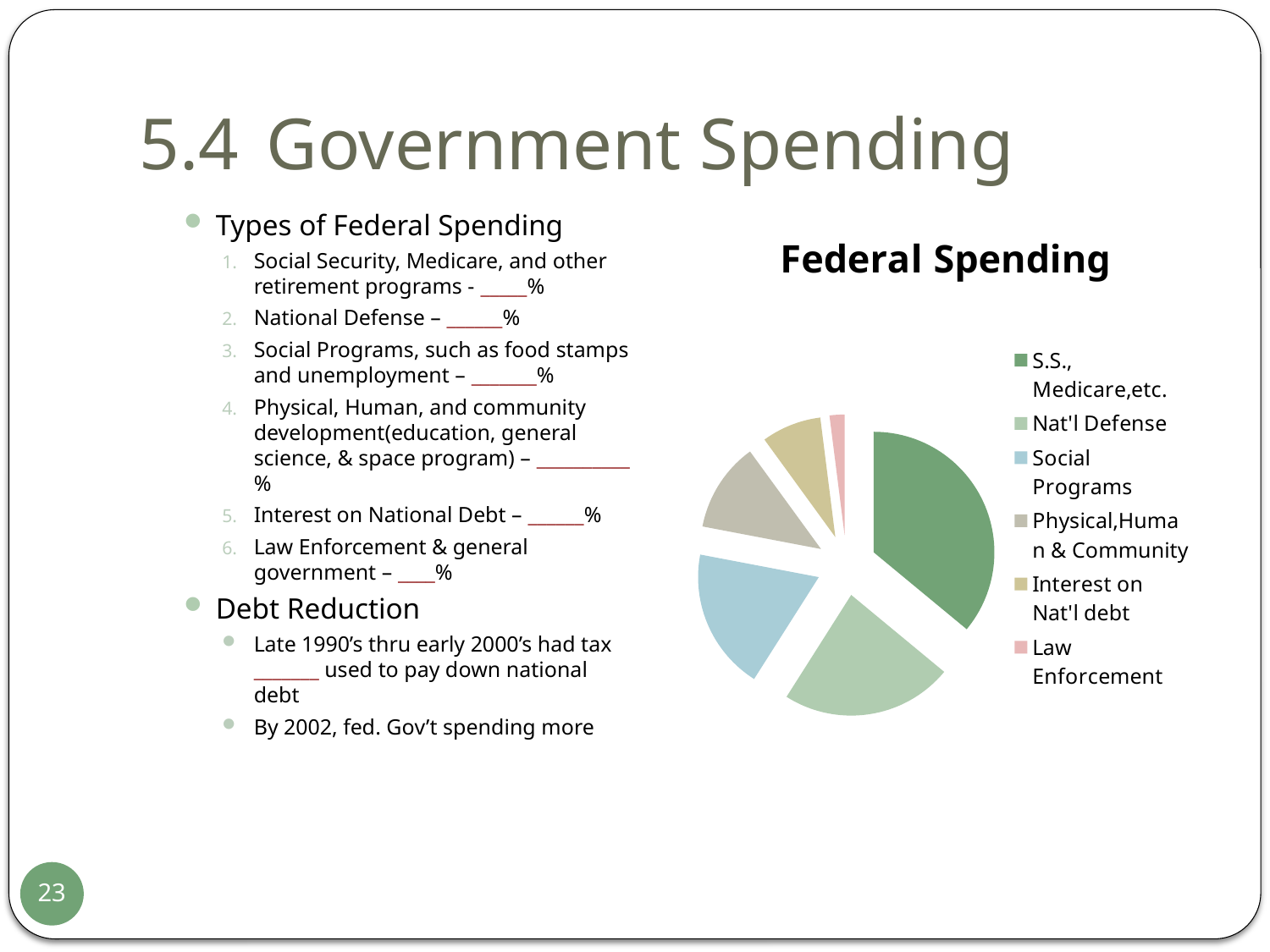
In the Federal Spending pie chart, which slice is larger: Nat'l Defense or Social Programs? Nat'l Defense How many entries does the legend of the Federal Spending chart list? 6 Which category has the smallest slice in the Federal Spending pie chart? Law Enforcement Which legend entry in the Federal Spending chart is shown in pink? Law Enforcement How many slices does the Federal Spending pie chart have? 6 What kind of chart is shown on the slide? pie chart In the Federal Spending pie chart, which slice is larger: Nat'l Defense or Law Enforcement? Nat'l Defense What is the title of the chart? Federal Spending In the Federal Spending pie chart, which slice is larger: Social Programs or Interest on Nat'l debt? Social Programs Which category has the largest slice in the Federal Spending pie chart? S.S., Medicare,etc.